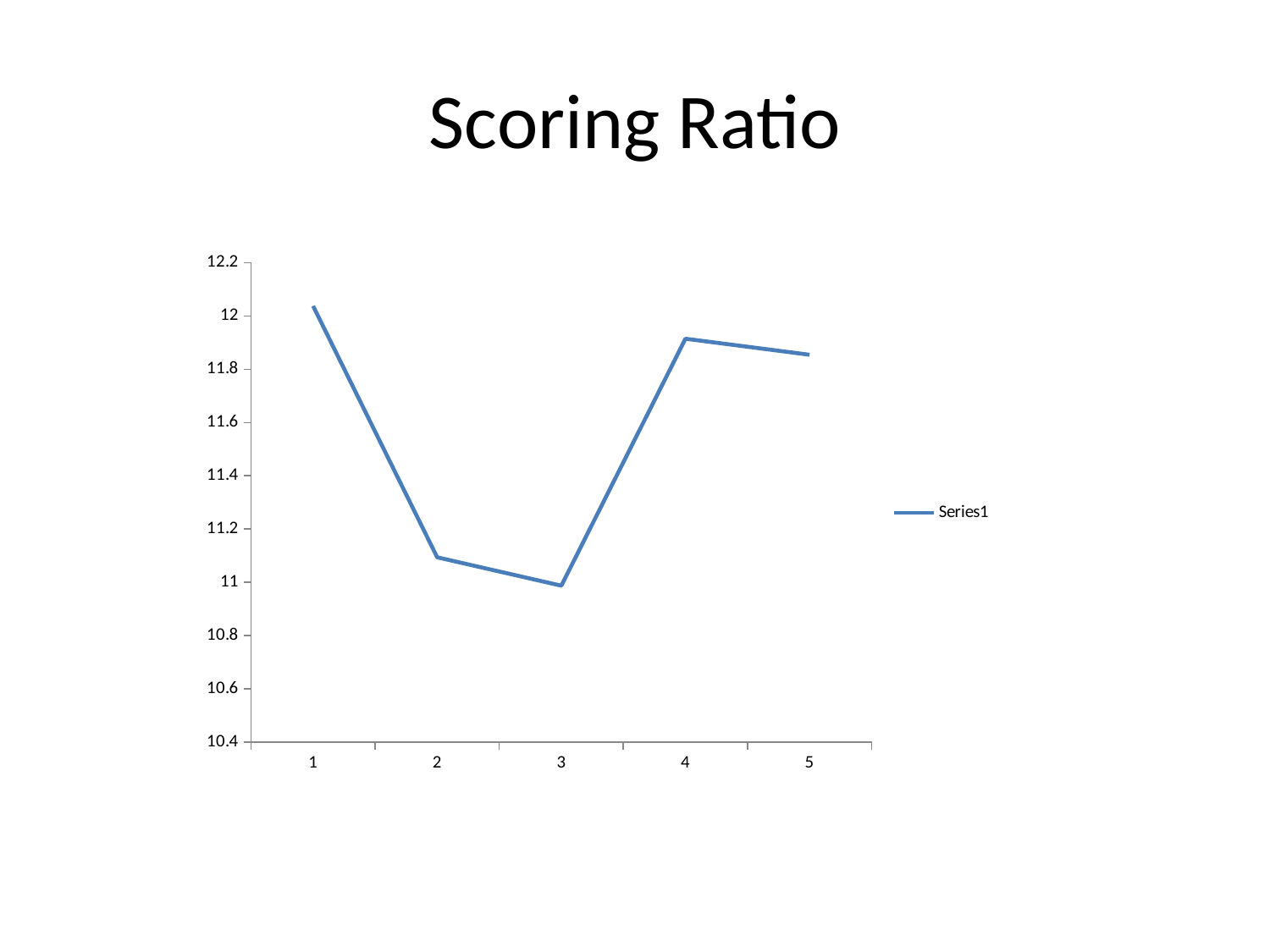
What kind of chart is shown on the slide? line chart What is the name of the series shown in the legend? Series1 How many series does the legend list? 1 How many points are plotted along the x axis? 5 What is the title of the chart? Scoring Ratio At which x-axis category is the value lowest? 3 Which has the larger value, category 2 or category 5? 5 Is the value at category 1 greater or less than 12? greater At which x-axis category is the value highest? 1 Do the values rise or fall from category 1 to category 3? fall Is the value at category 4 greater or less than 11.8? greater